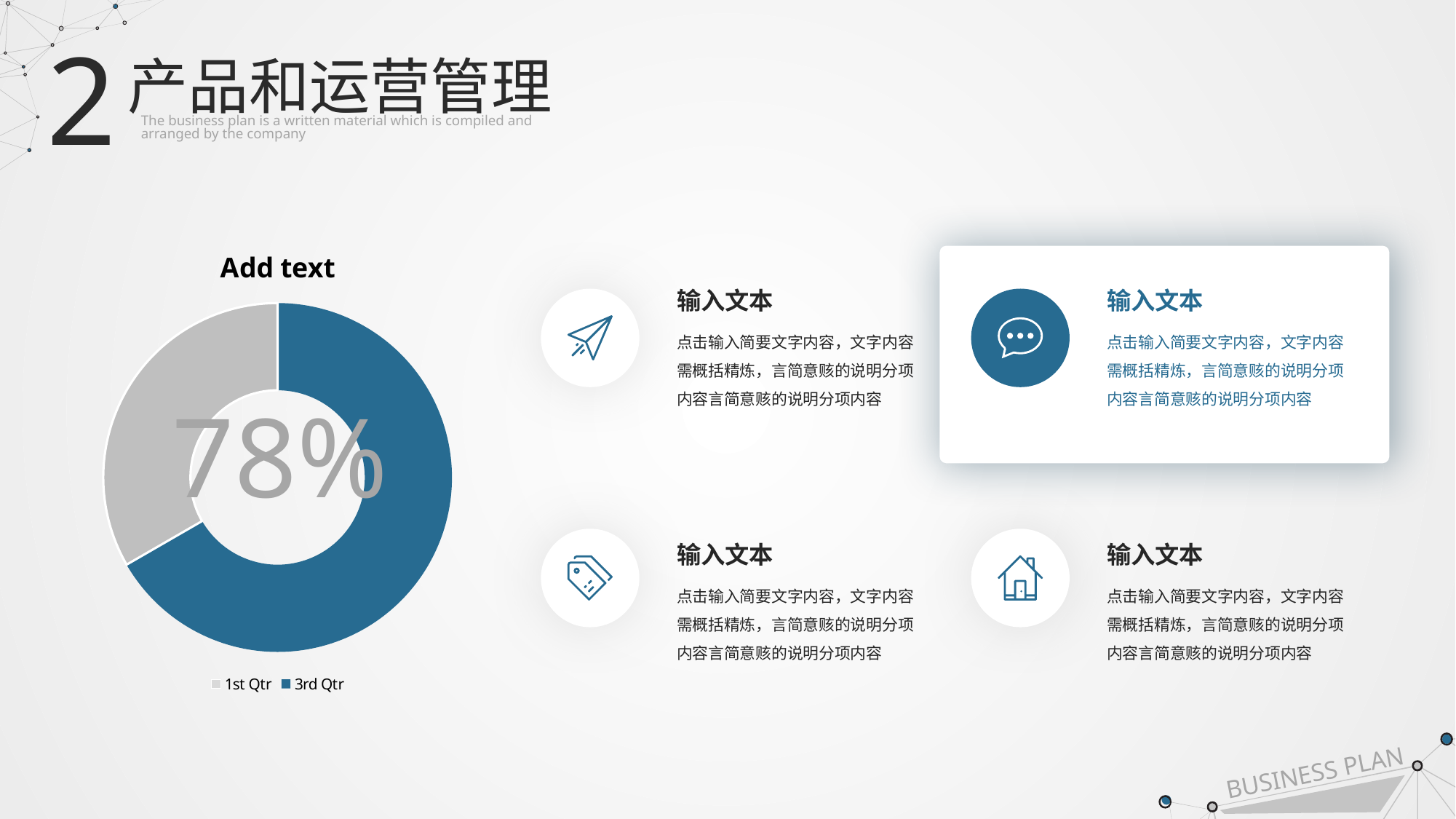
What kind of chart is shown on the slide? doughnut chart What is the title of the chart? Add text How many slices does the doughnut chart have? 2 Which category has the smallest slice in the chart? 1st Qtr What percentage is printed in the centre of the doughnut chart? 78% Which slice is larger, 1st Qtr or 3rd Qtr? 3rd Qtr Which category has the largest slice in the chart? 3rd Qtr How many entries does the chart's legend list? 2